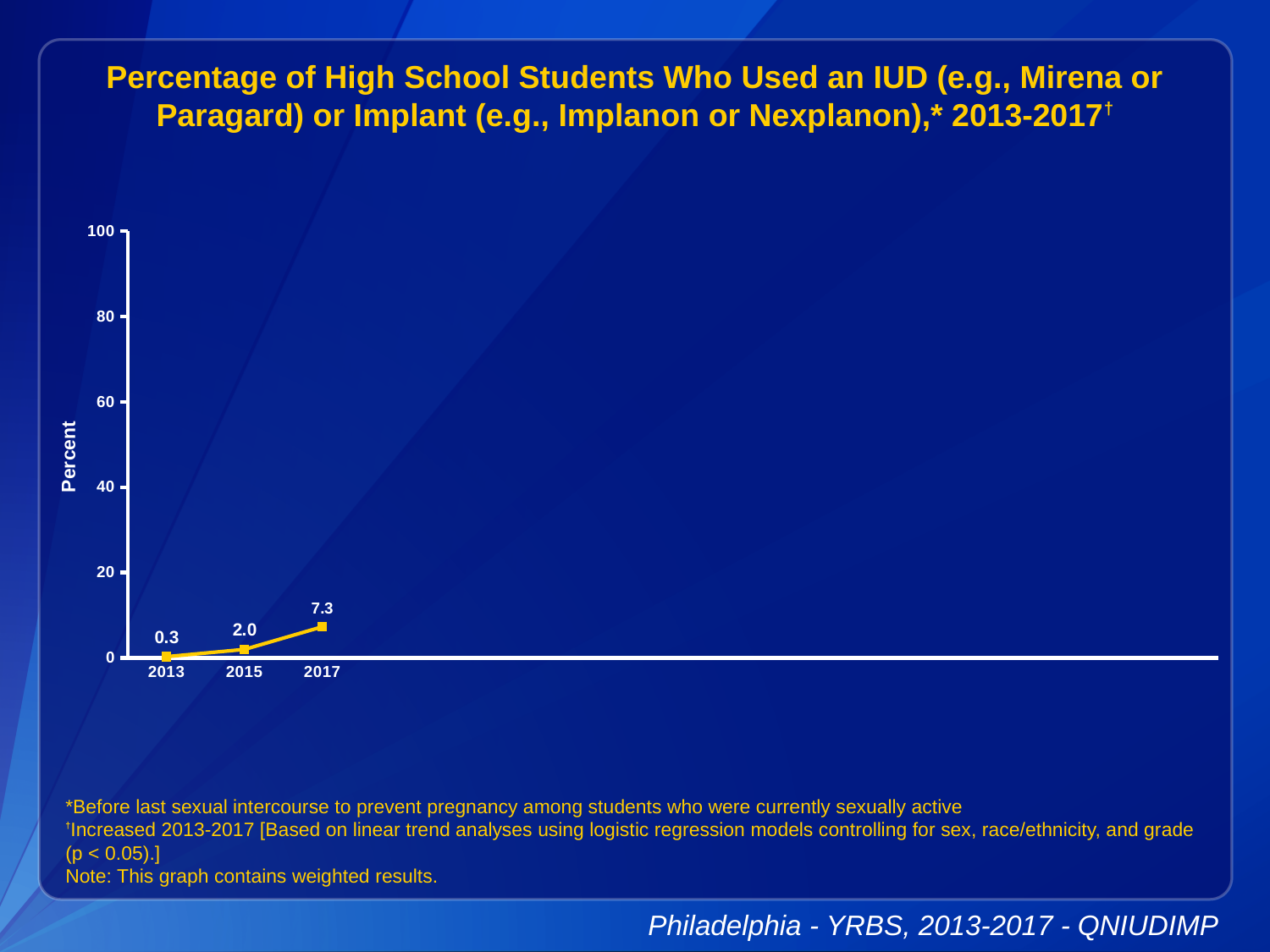
What is the value for 2015? 2.0 How many years are plotted on the chart? 3 Is the value for 2017 greater or less than 20? less Which year has the highest value? 2017 What is the difference between the values for 2017 and 2015? 5.3 What kind of chart is shown? line chart What is the difference between the values for 2017 and 2013? 7.0 Which is larger, the value for 2015 or the value for 2017? 2017 Do the values rise or fall from 2013 to 2017? rise What is the value for 2013? 0.3 Which year has the lowest value? 2013 What is the value for 2017? 7.3